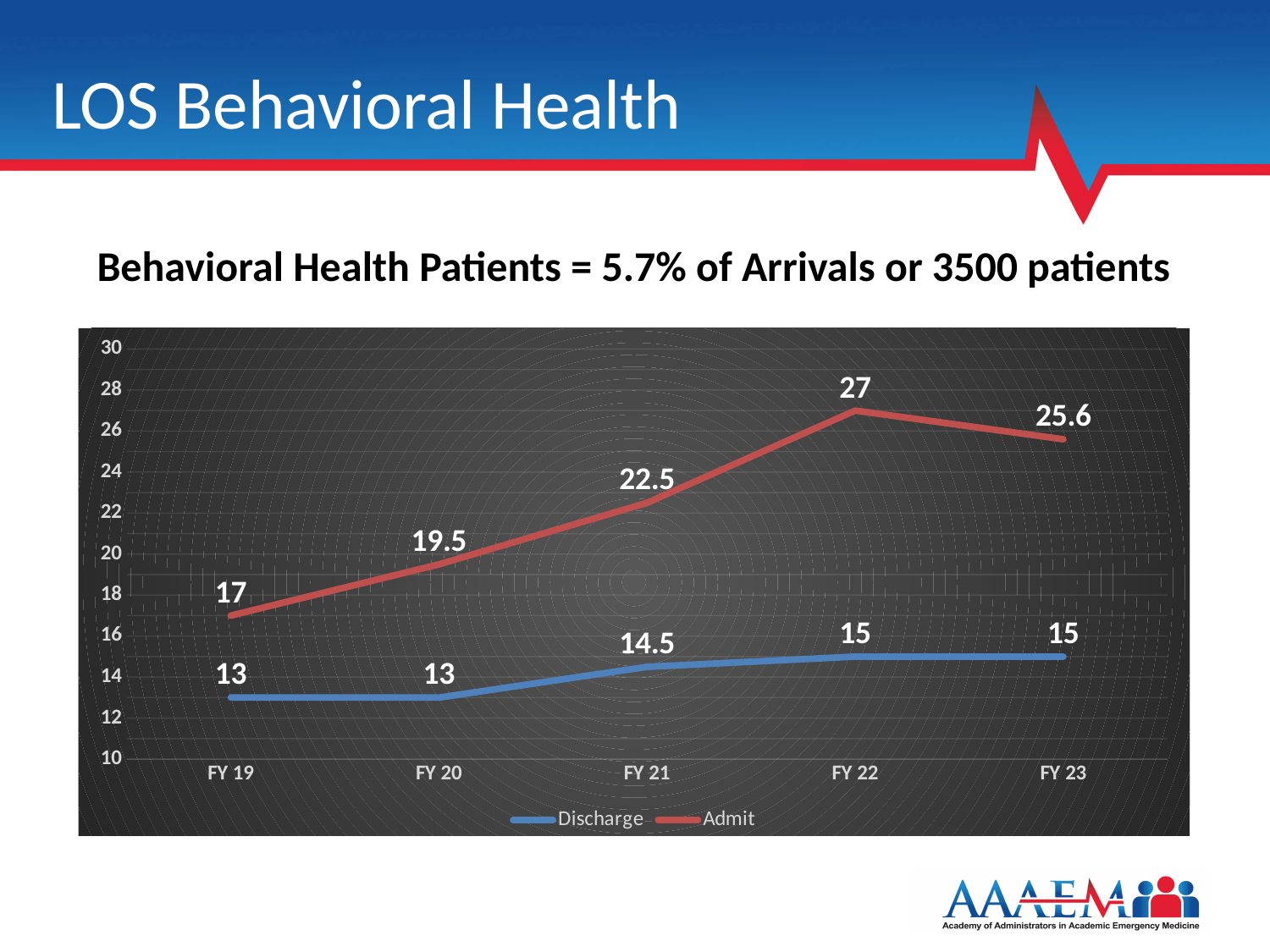
What is the difference between the Admit and Discharge values in FY 23? 10.6 In which fiscal years is the Discharge value lowest? FY 19 and FY 20 What is the Discharge value for FY 21? 14.5 What kind of chart is shown on the slide? Line chart Does the Admit line rise or fall from FY 19 to FY 22? Rise In which fiscal year is the Admit value highest? FY 22 What is the Admit value for FY 19? 17 Is the Admit value for FY 21 greater or less than 20? greater Which is larger in FY 20, the Admit value or the Discharge value? Admit What is the Admit value for FY 22? 27 How many series does the legend list? 2 How many fiscal years are shown on the x axis? 5